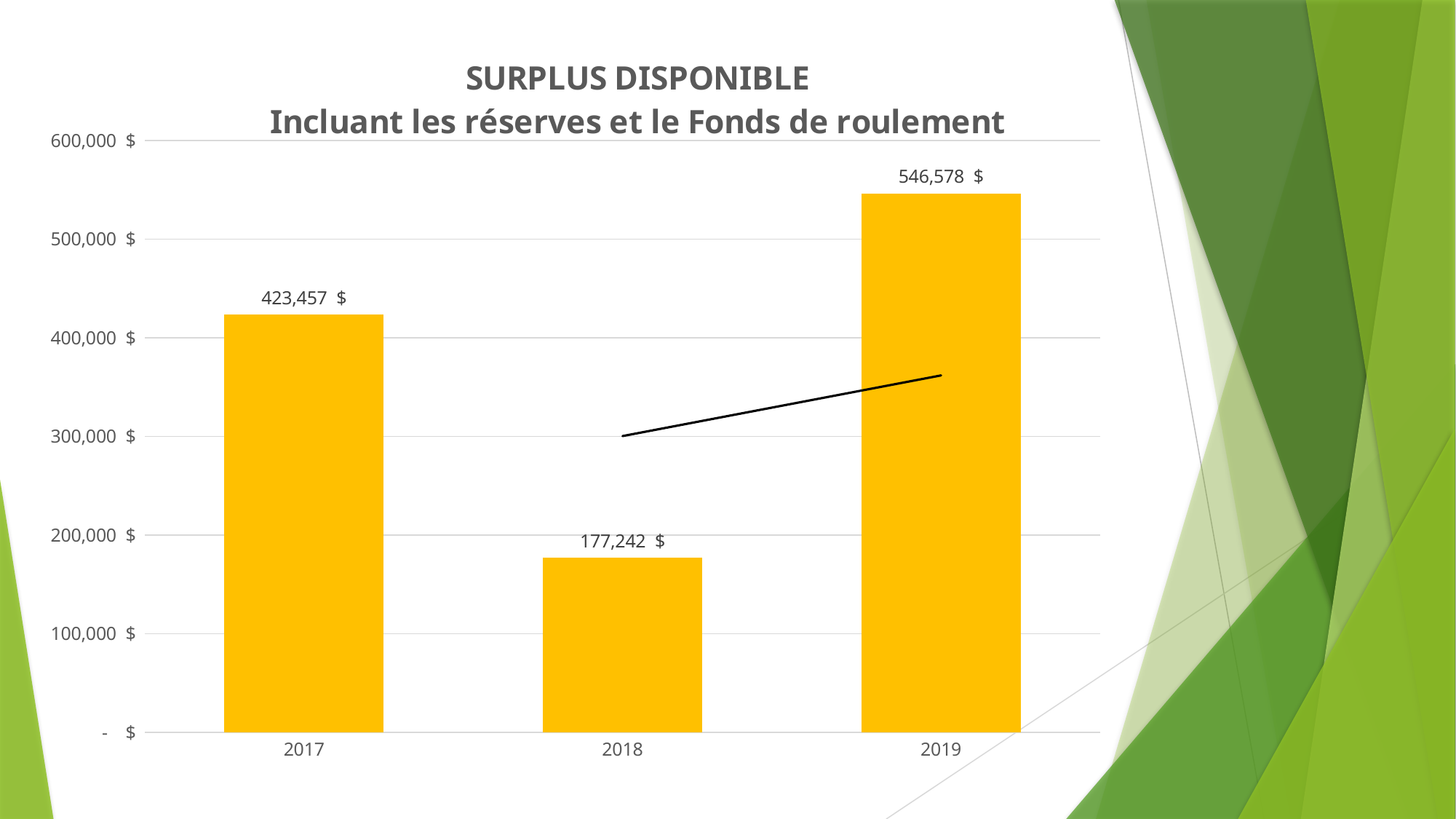
Which year has the lowest value? 2018 What is the value for 2017? 423,457 $ How many years are shown on the x axis? 3 What kind of chart is shown on the slide? bar chart What is the value for 2019? 546,578 $ Is the value for 2019 greater or less than 500,000 $? greater What is the value for 2018? 177,242 $ Which is larger, the value for 2017 or the value for 2018? 2017 What is the title of the chart? SURPLUS DISPONIBLE Incluant les réserves et le Fonds de roulement Which year has the highest value? 2019 What is the difference between the values for 2017 and 2018? 246,215 $ What is the difference between the values for 2019 and 2017? 123,121 $